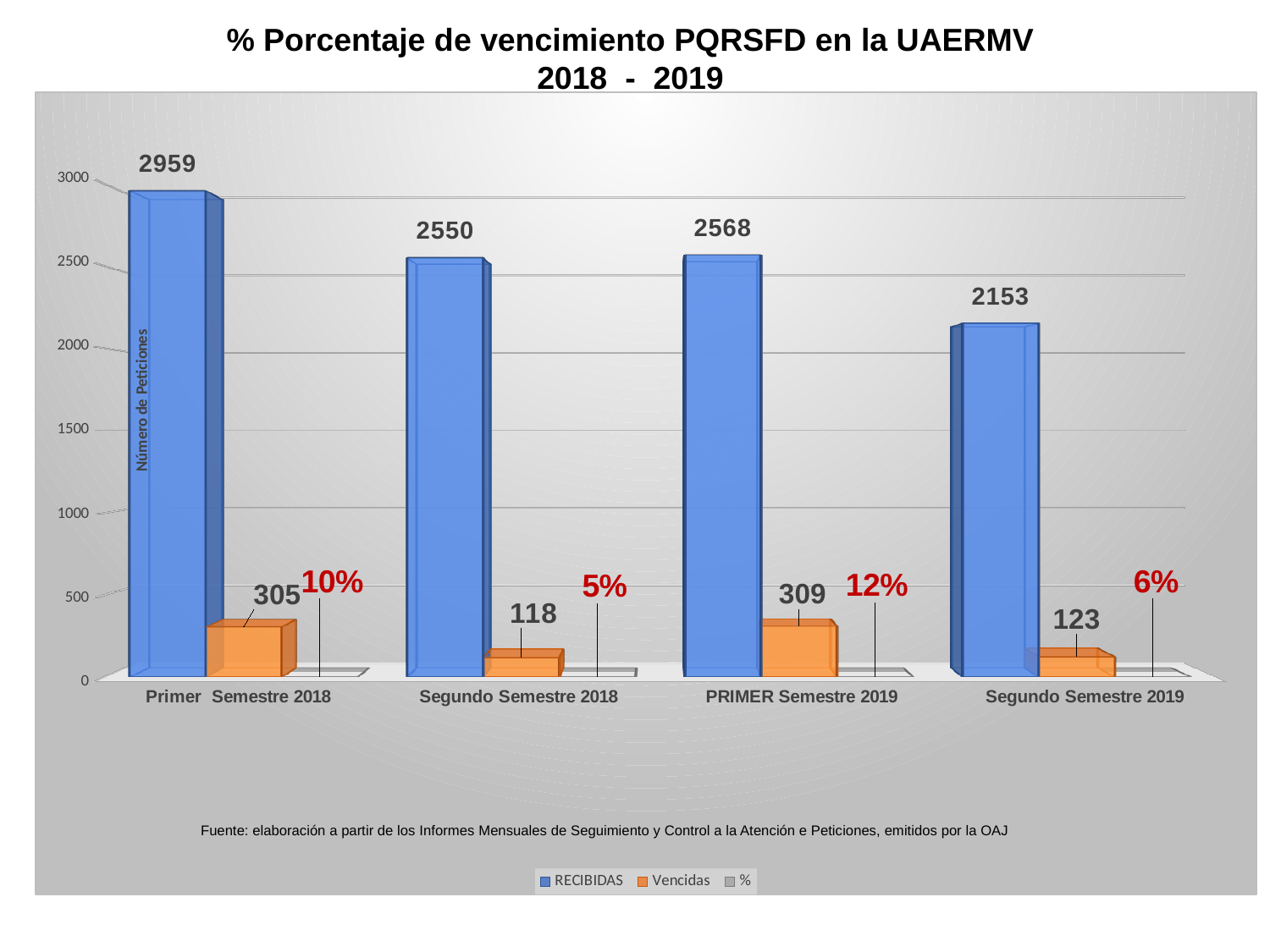
Is the RECIBIDAS value for Segundo Semestre 2019 greater or less than 2500? less What kind of chart is shown on the slide? bar chart What is the difference between the RECIBIDAS values for Primer Semestre 2018 and Segundo Semestre 2019? 806 What is the label of the vertical axis? Número de Peticiones What is the Vencidas value for Segundo Semestre 2018? 118 Which is larger, the Vencidas value for Primer Semestre 2018 or for PRIMER Semestre 2019? PRIMER Semestre 2019 Which semester has the highest RECIBIDAS value? Primer Semestre 2018 What percentage is shown for PRIMER Semestre 2019? 12% How many series does the legend list? 3 Which semester has the lowest Vencidas value? Segundo Semestre 2018 What is the RECIBIDAS value for Primer Semestre 2018? 2959 How many semesters are shown on the x axis? 4